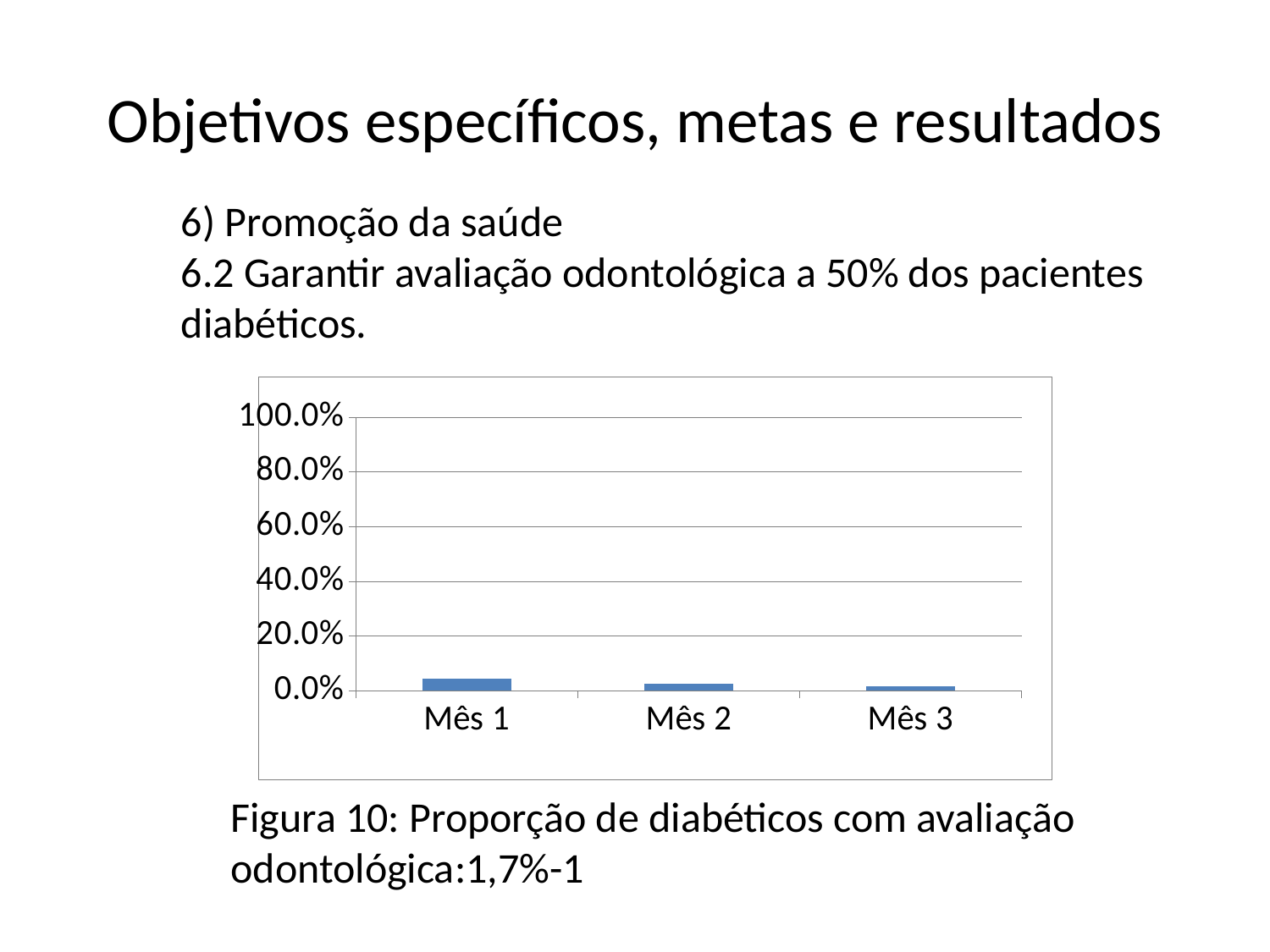
What figure number is given in the caption below the chart? Figura 10 How many categories are plotted on the x axis of the chart? 3 What kind of chart is shown on the slide? bar chart What is the highest tick value shown on the y axis of the chart? 100.0% Which month has the lowest bar in the chart? Mês 3 Which is larger, the value for Mês 1 or the value for Mês 3? Mês 1 Which is larger, the value for Mês 1 or the value for Mês 2? Mês 1 Is the value for Mês 3 greater or less than 20.0%? less Is the value for Mês 1 greater or less than 20.0%? less Do the values rise or fall from Mês 1 to Mês 3? fall Which month has the highest bar in the chart? Mês 1